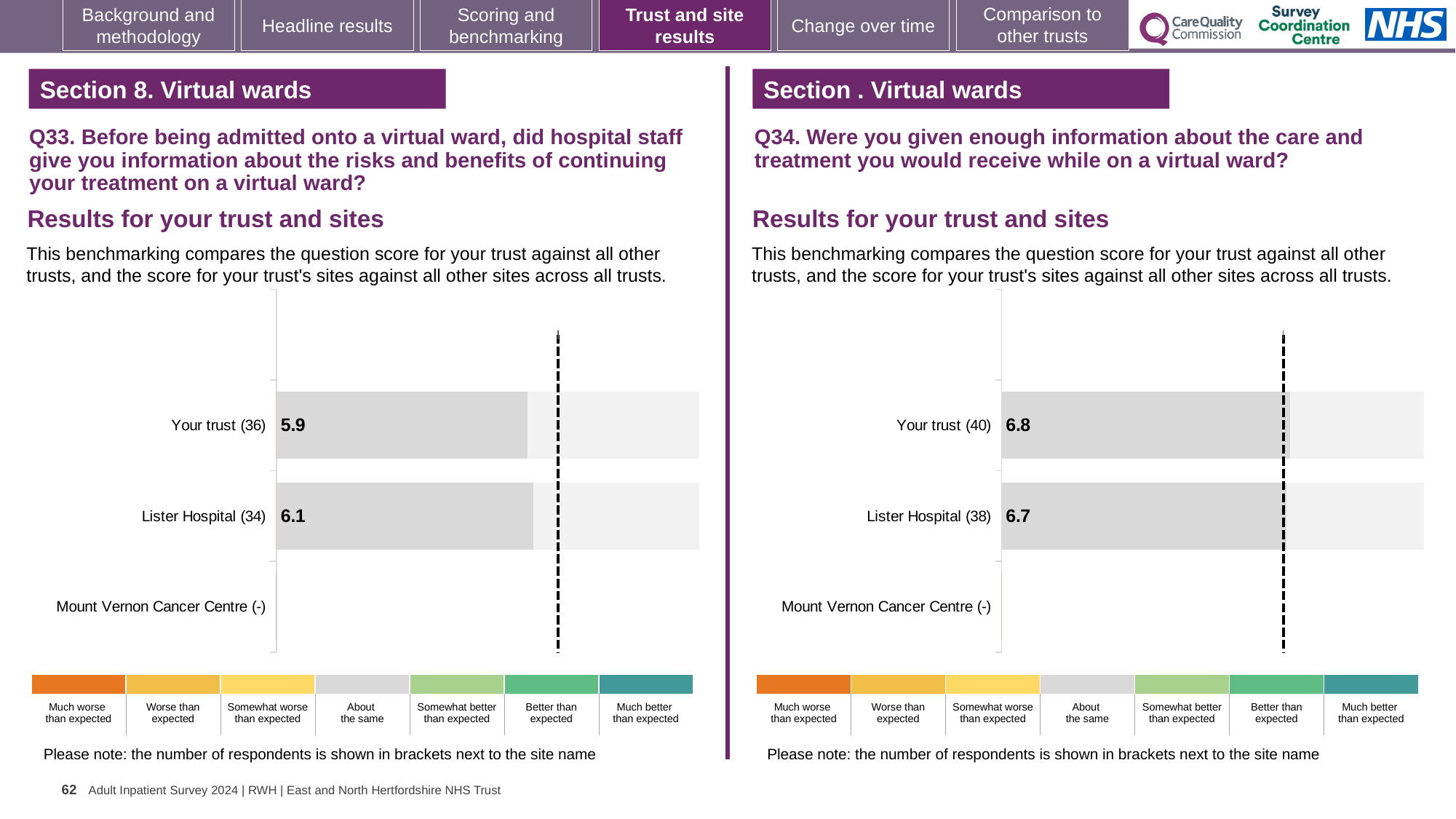
In the Q33 chart on the left, how many respondents are shown in brackets for Your trust? 36 In the Q34 chart on the right, what is the difference between the Your trust score and the Lister Hospital score? 0.1 In the Q34 chart on the right, what is the score for Lister Hospital? 6.7 In the Q33 chart on the left, which has the higher score, Your trust or Lister Hospital? Lister Hospital How many categories are listed on the y axis of the Q33 chart on the left? 3 In the Q33 chart on the left, what is the difference between the Lister Hospital score and the Your trust score? 0.2 In the Q33 chart on the left, what is the score for Lister Hospital? 6.1 In the Q34 chart on the right, how many respondents are shown in brackets for Lister Hospital? 38 What kind of chart is the Q34 chart on the right? Bar chart In the Q34 chart on the right, what is the score for Your trust? 6.8 In the Q33 chart on the left, what is the score for Your trust? 5.9 In the Q34 chart on the right, which has the higher score, Your trust or Lister Hospital? Your trust